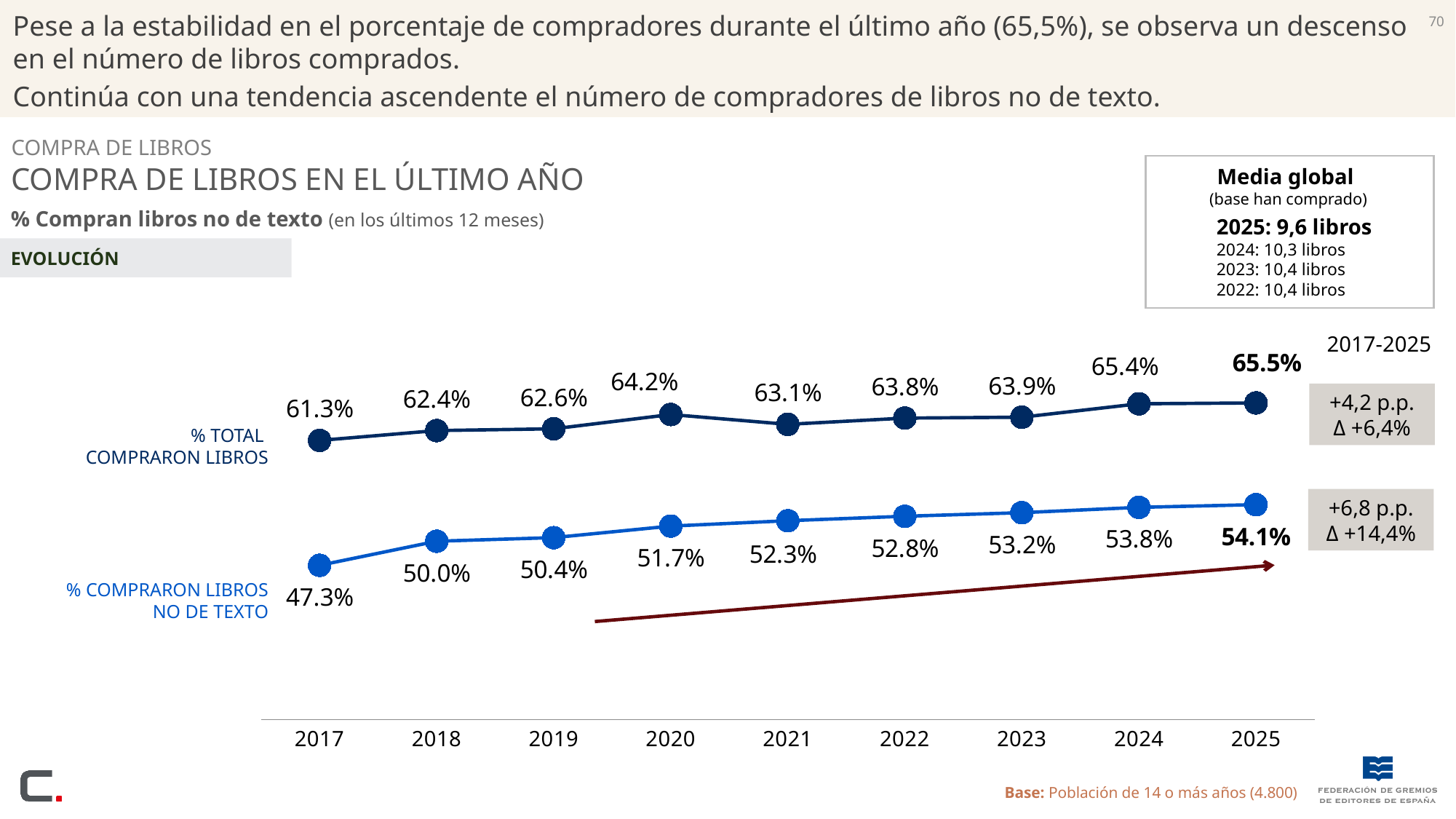
Does % COMPRARON LIBROS NO DE TEXTO rise or fall from 2017 to 2025? Rise What is the value for % COMPRARON LIBROS NO DE TEXTO in 2017? 47.3% What is the value for % TOTAL COMPRARON LIBROS in 2020? 64.2% In which year is % COMPRARON LIBROS NO DE TEXTO lowest? 2017 What is the difference between % TOTAL COMPRARON LIBROS and % COMPRARON LIBROS NO DE TEXTO in 2025? 11.4 percentage points How many years are plotted on the x axis? 9 Which is larger for % TOTAL COMPRARON LIBROS: the value in 2020 or the value in 2021? 2020 What is the value for % TOTAL COMPRARON LIBROS in 2025? 65.5% How many series are plotted on the chart? 2 What is the value for % COMPRARON LIBROS NO DE TEXTO in 2021? 52.3% In which year is % TOTAL COMPRARON LIBROS highest? 2025 What kind of chart is shown? Line chart